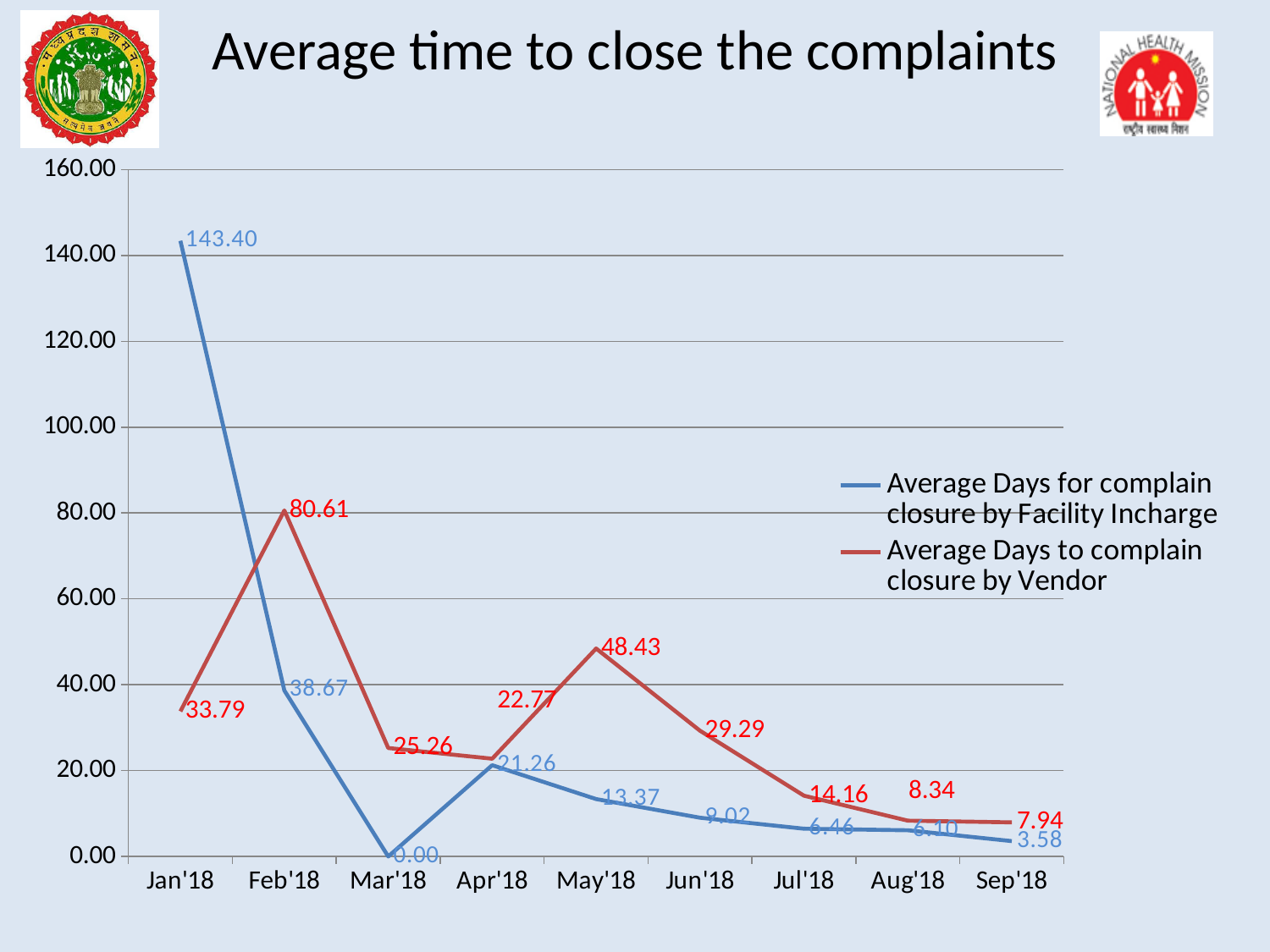
What is the value for Average Days to complain closure by Vendor in Feb'18? 80.61 What kind of chart is shown on the slide? line chart What is the value for Average Days for complain closure by Facility Incharge in Jan'18? 143.40 In which month is the Average Days for complain closure by Facility Incharge lowest? Mar'18 What is the value for Average Days to complain closure by Vendor in May'18? 48.43 In Jan'18, which series has the larger value: Facility Incharge or Vendor? Facility Incharge In which month is the Average Days to complain closure by Vendor highest? Feb'18 Is the value for Average Days to complain closure by Vendor in Jun'18 greater or less than 20.00? greater What is the value for Average Days for complain closure by Facility Incharge in Apr'18? 21.26 How many months are plotted on the x axis? 9 In Feb'18, what is the difference between the Vendor value and the Facility Incharge value? 41.94 How many series does the legend list? 2